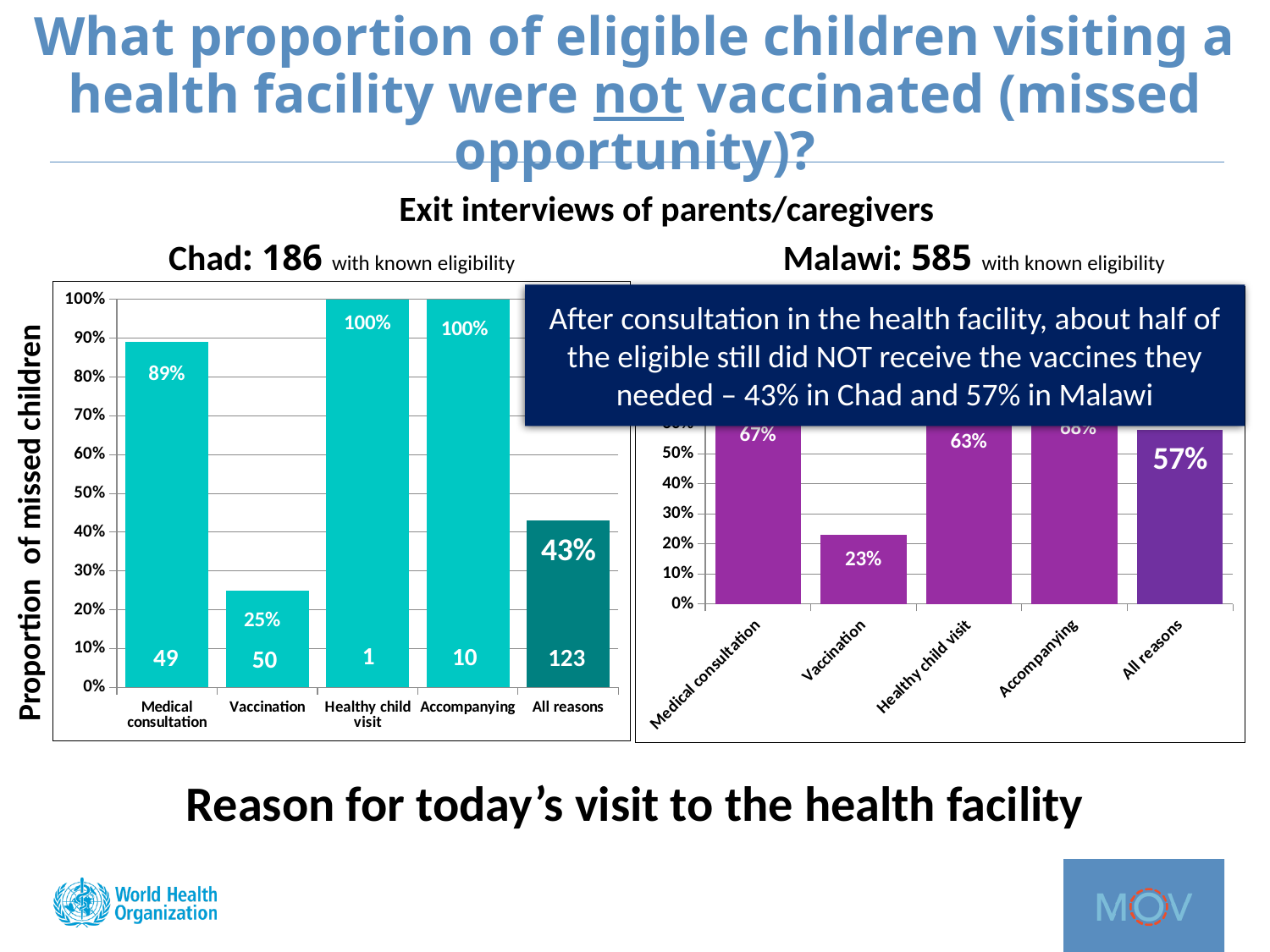
In the Chad chart, what is the difference between the proportions for Medical consultation and Vaccination? 64% In the Malawi chart, what proportion of missed children is shown for All reasons? 57% In the Chad chart, what proportion of missed children is shown for All reasons? 43% In the Chad chart, what proportion of missed children is shown for Vaccination? 25% In the Chad chart, which reason for visit has the lowest proportion of missed children? Vaccination In the Malawi chart, which reason for visit has the lowest proportion of missed children? Vaccination How many reason-for-visit categories are shown on the x axis of the Chad chart? 5 In the Chad chart, what proportion of missed children is shown for Medical consultation? 89% In the Malawi chart, is the value for Medical consultation greater or less than 50%? greater In the Malawi chart, what proportion of missed children is shown for Vaccination? 23% In the Chad chart, what number is printed at the base of the All reasons bar? 123 In the Malawi chart, what proportion of missed children is shown for Healthy child visit? 63%